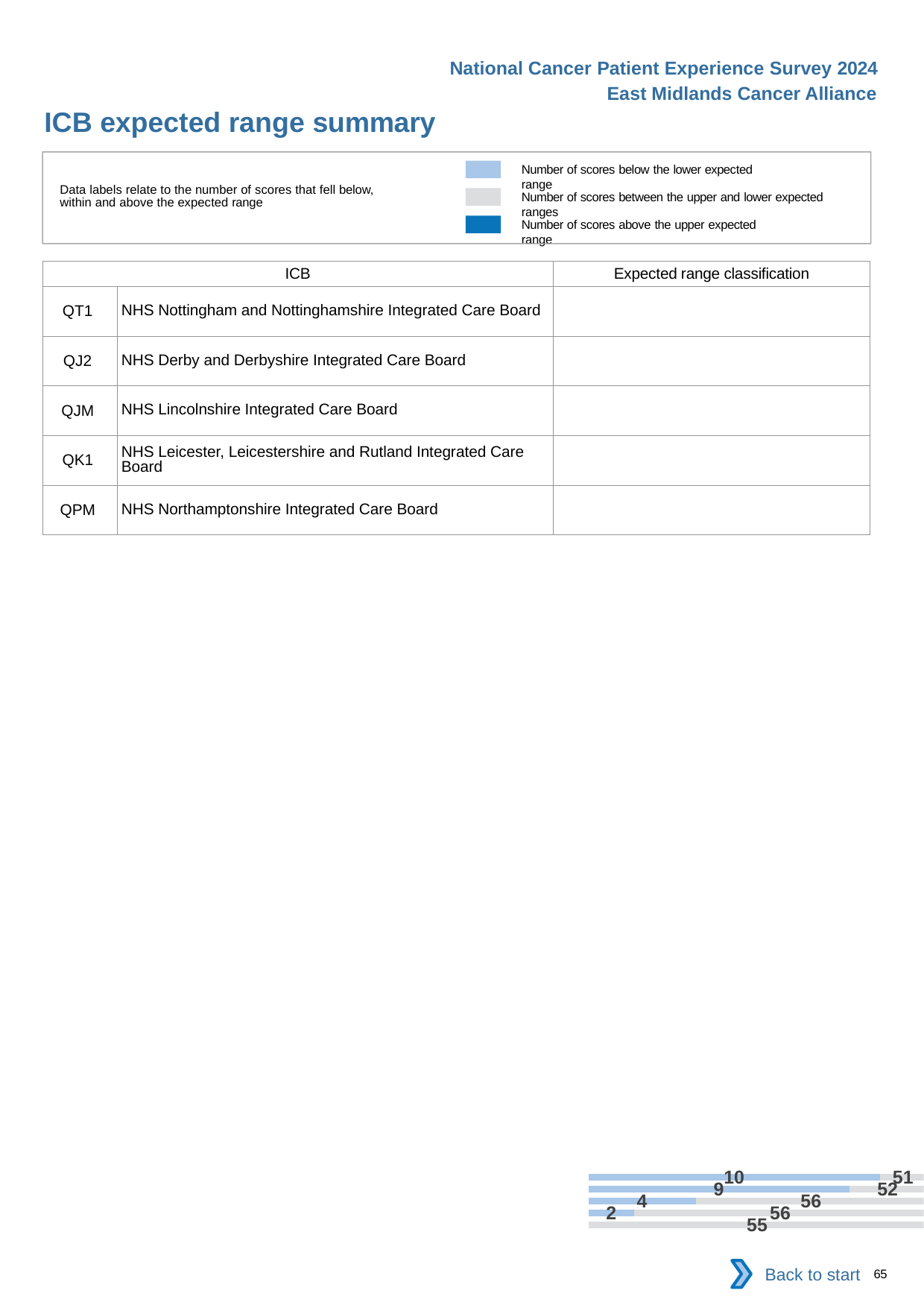
In the chart at the bottom of the slide, is the grey value on the third bar from the top larger or smaller than the grey value on the top bar? larger In the chart at the bottom of the slide, which bar has the largest light blue (below the lower expected range) value? the top bar In the chart at the bottom of the slide, what is the total of the labelled segments on the third bar from the top? 60 According to the legend, which colour represents the number of scores above the upper expected range? dark blue How many bars are plotted in the chart at the bottom of the slide? 5 In the chart at the bottom of the slide, what is the total of the labelled segments on the fourth bar from the top? 58 In the chart at the bottom of the slide, what is the total of the labelled segments on the top bar? 61 In the chart at the bottom of the slide, what is the grey (within expected range) value on the top bar? 51 How many series does the legend list for the chart? 3 What kind of chart is shown at the bottom of the slide? bar chart In the chart at the bottom of the slide, what is the light blue value on the second bar from the top? 9 In the chart at the bottom of the slide, what is the light blue (below the lower expected range) value on the top bar? 10